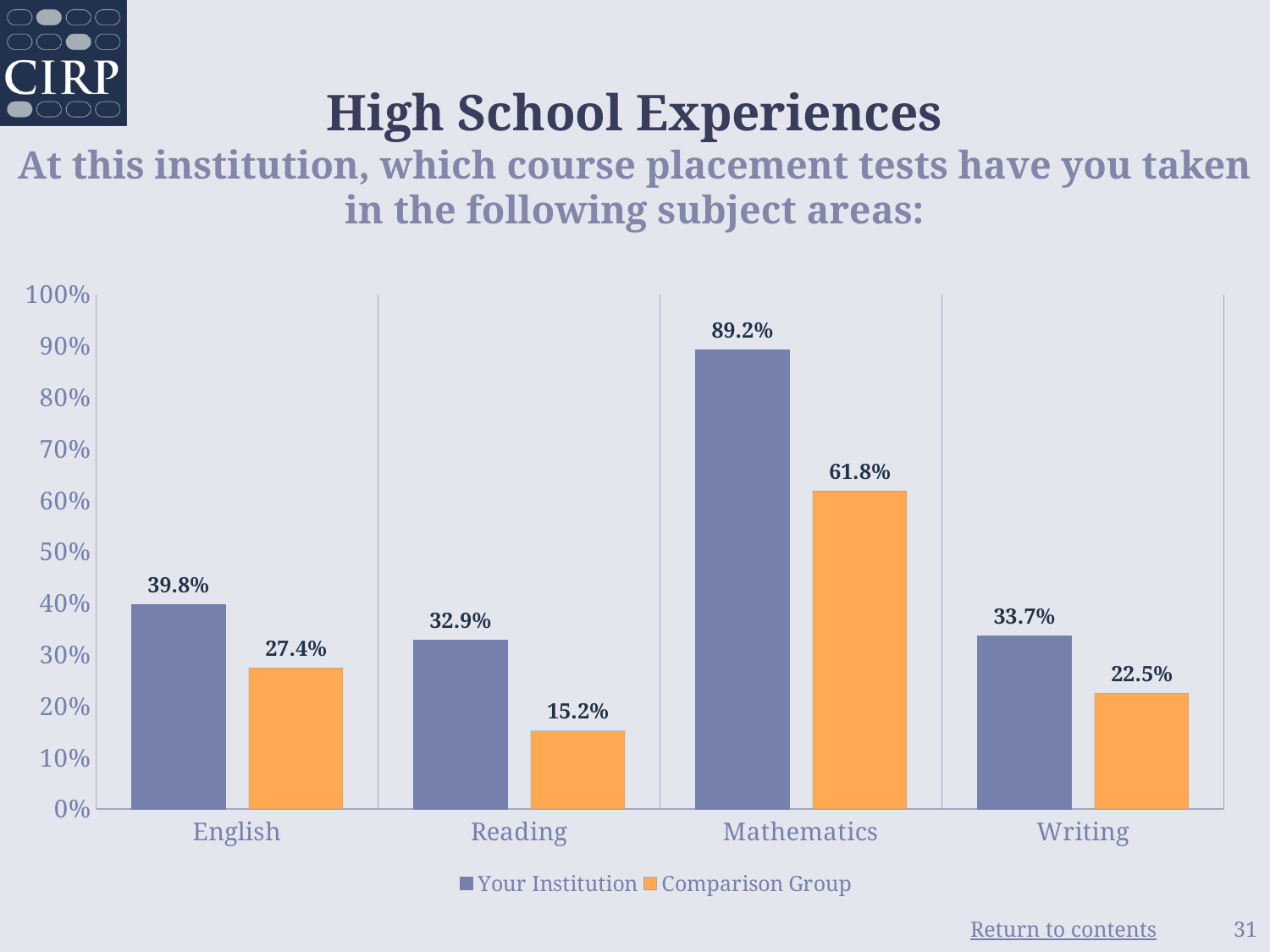
What is the value for Your Institution in Writing? 33.7% Is the value for Comparison Group in Mathematics greater or less than 70%? less Which is larger: Comparison Group in English or Comparison Group in Writing? Comparison Group in English How many subject areas are shown on the x axis? 4 What is the difference between Your Institution and Comparison Group in Mathematics? 27.4% What kind of chart is shown on the slide? bar chart What is the difference between Your Institution and Comparison Group in English? 12.4% What is the value for Your Institution in Mathematics? 89.2% How many series does the legend list? 2 Which subject area has the lowest value for Your Institution? Reading Which subject area has the highest value for Comparison Group? Mathematics What is the value for Comparison Group in Reading? 15.2%